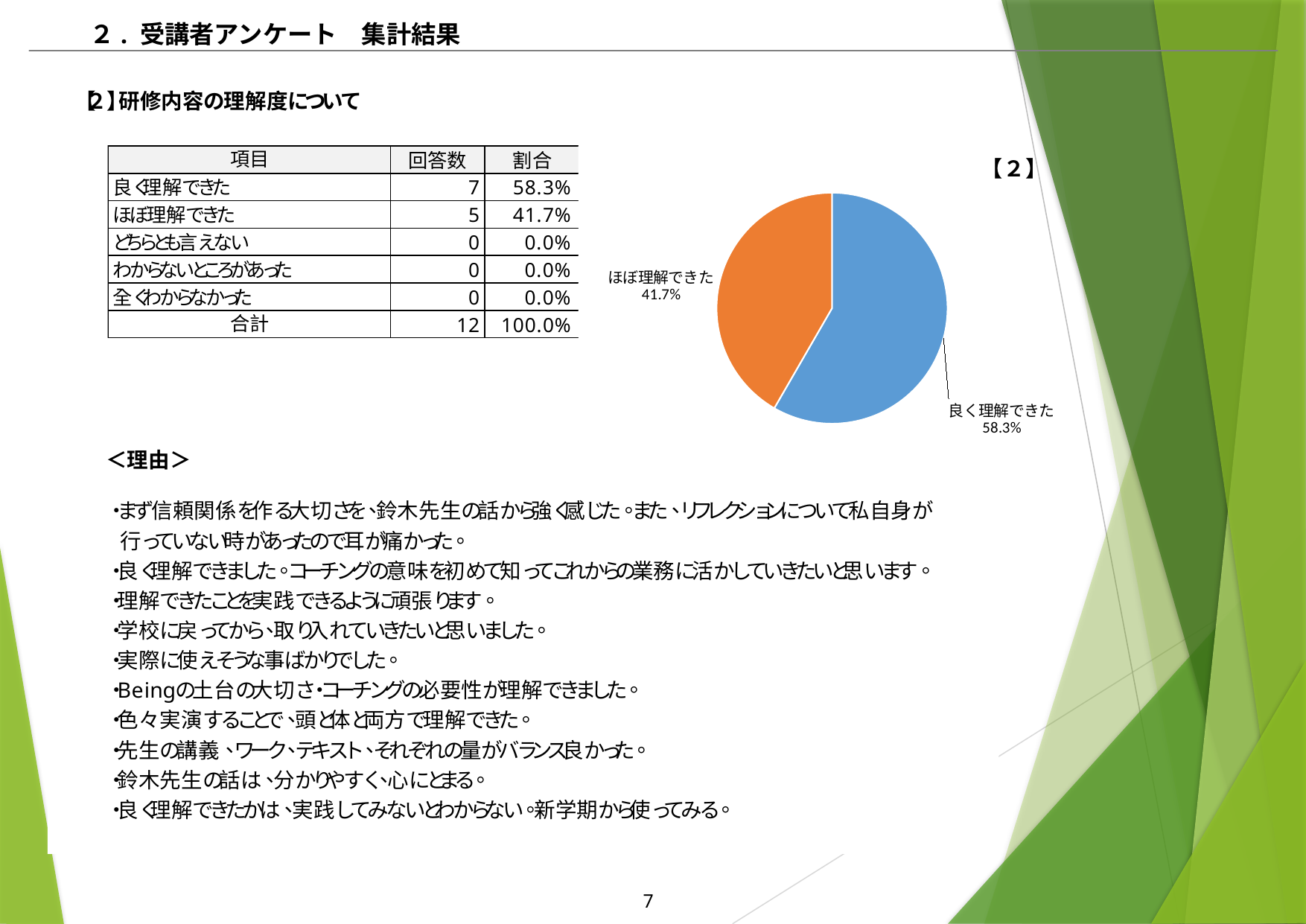
How many labelled slices does the pie chart show? 2 What kind of chart is shown on the slide? pie chart What share of the pie does 良く理解できた have? 58.3% Which slice of the pie chart is the smallest? ほぼ理解できた What is the difference in percentage points between the 良く理解できた slice and the ほぼ理解できた slice? 16.6 Which is larger in the pie chart, 良く理解できた or ほぼ理解できた? 良く理解できた What is the title shown above the pie chart? 【２】 Is the share for ほぼ理解できた greater or less than 50%? less What colour is the 良く理解できた slice in the pie chart? blue Is the share for 良く理解できた greater or less than 50%? greater What share of the pie does ほぼ理解できた have? 41.7% Which slice of the pie chart is the largest? 良く理解できた